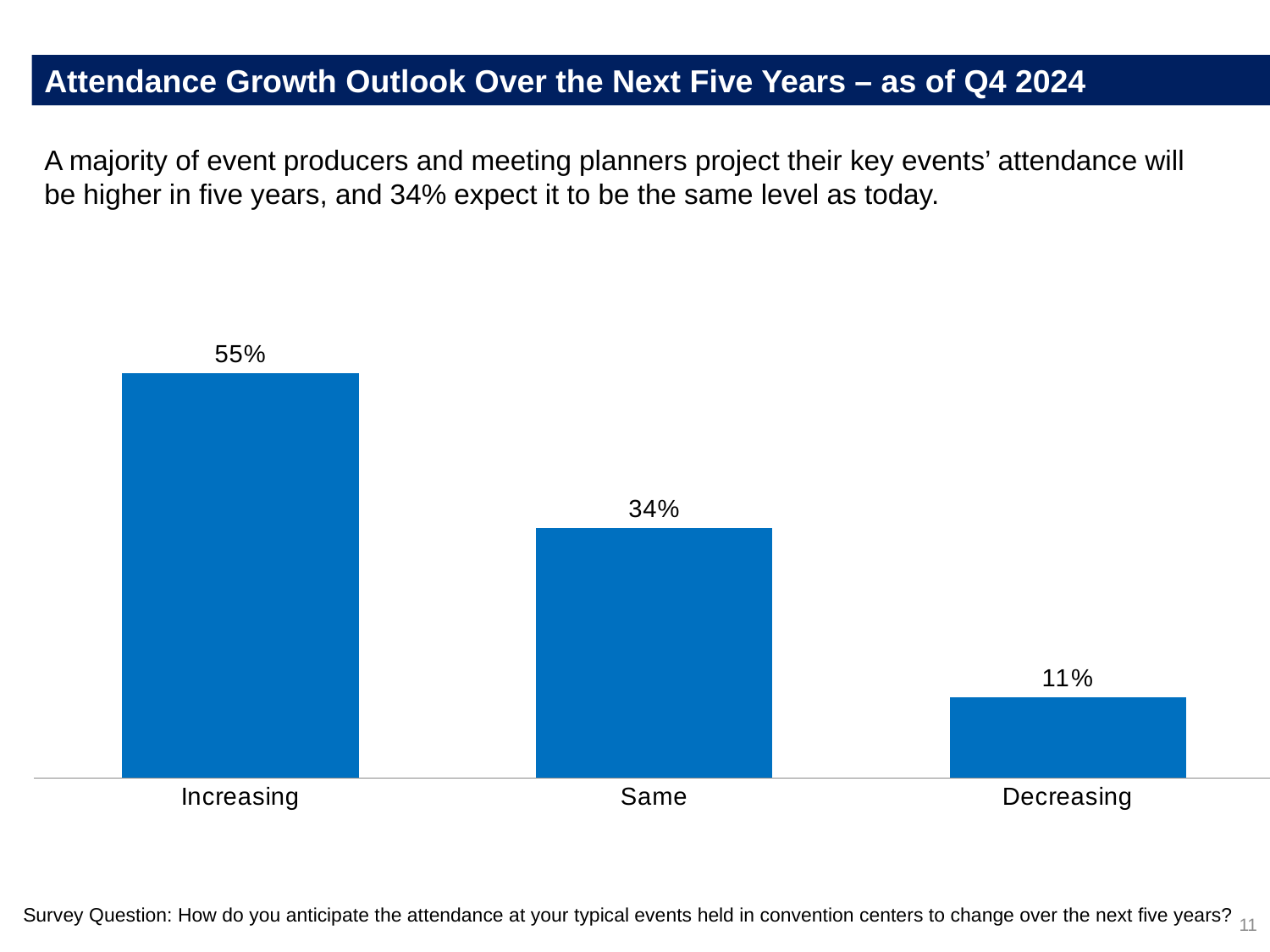
What is the title of the slide containing the chart? Attendance Growth Outlook Over the Next Five Years – as of Q4 2024 What percentage of respondents expect attendance to be Increasing? 55% Which category has the highest value? Increasing Which category has the lowest value? Decreasing Do the values rise or fall from left to right across the categories? Fall What kind of chart is shown on the slide? Bar chart What is the difference between the Same and Decreasing values? 23% Which is larger, the value for Same or the value for Decreasing? Same How many categories are shown in the chart? 3 What percentage of respondents expect attendance to be Decreasing? 11% What percentage of respondents expect attendance to stay the Same? 34% What is the difference between the Increasing and Same values? 21%